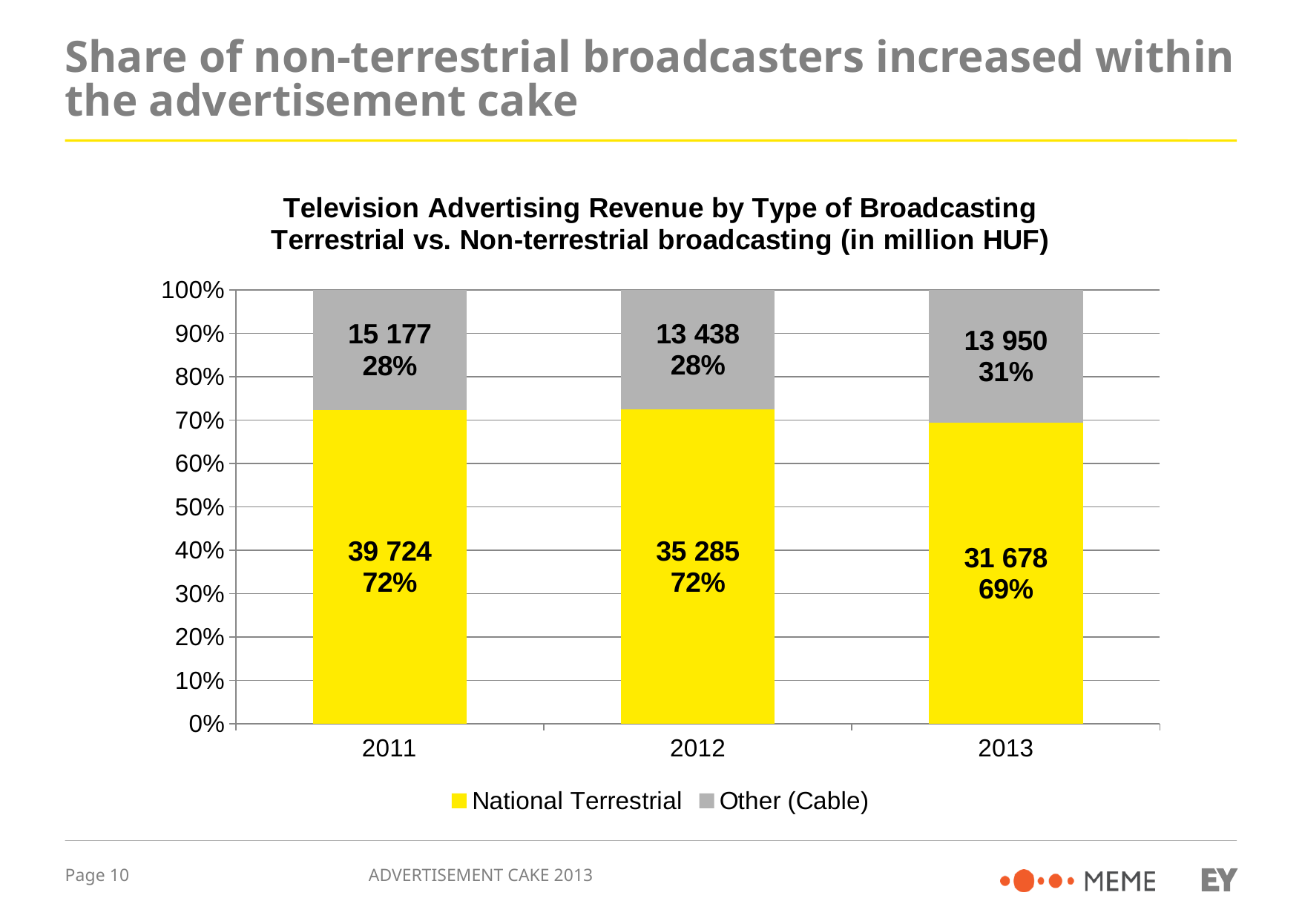
How many years are shown on the x axis? 3 Which is larger: the Other (Cable) revenue in 2012 or in 2013? 2013 What percentage share does Other (Cable) have in 2013? 31% What percentage share does National Terrestrial have in 2012? 72% What is the National Terrestrial revenue for 2011 in million HUF? 39 724 What is the total television advertising revenue for 2013 (National Terrestrial plus Other (Cable)), in million HUF? 45 628 What is the Other (Cable) revenue for 2013 in million HUF? 13 950 What is the difference between the National Terrestrial revenue in 2011 and in 2012, in million HUF? 4 439 In which year is the Other (Cable) revenue lowest? 2012 In which year is the National Terrestrial revenue highest? 2011 What kind of chart is shown on the slide? Stacked bar chart How many series does the legend list? 2